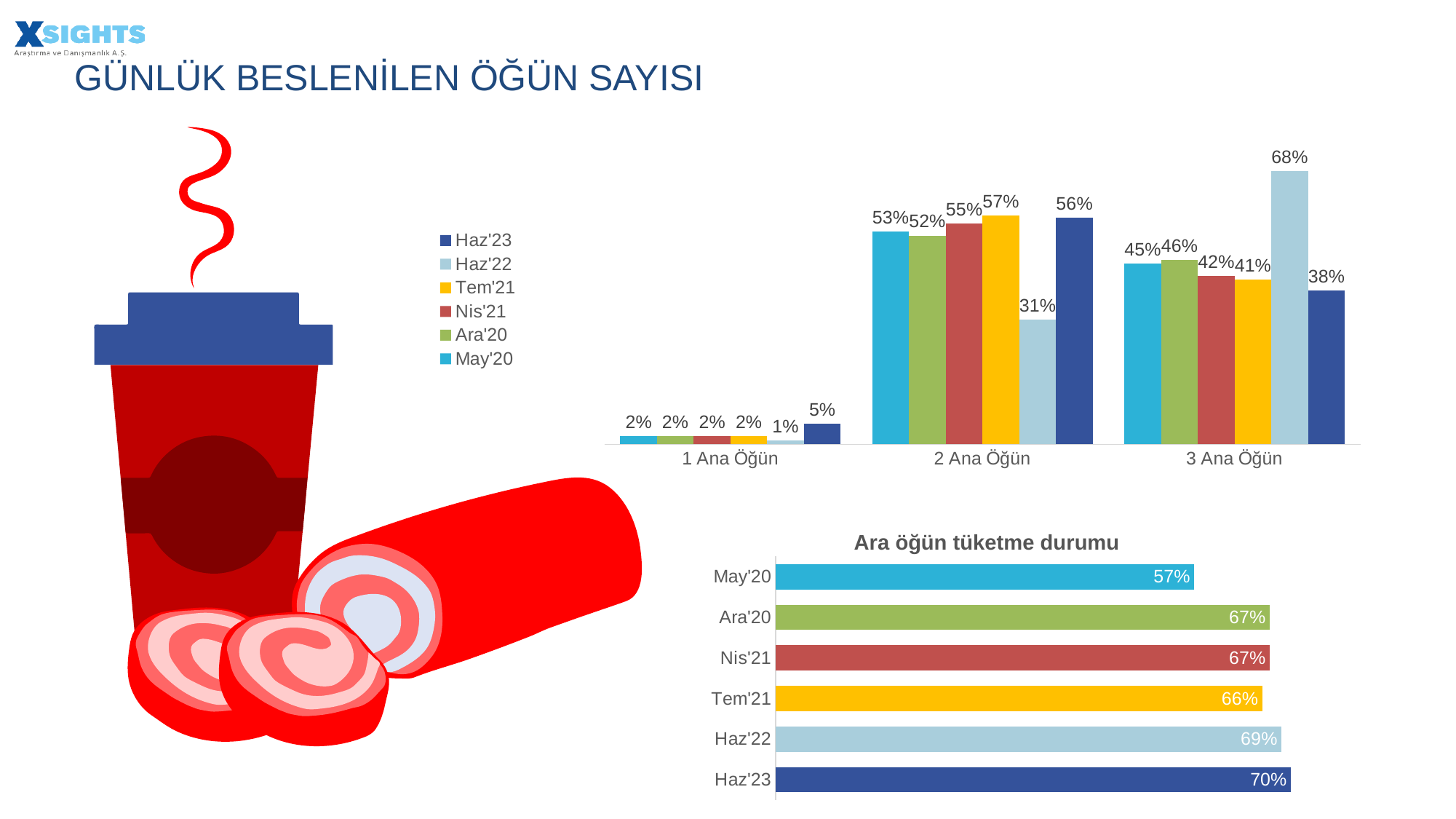
In the top grouped bar chart, which is larger for 2 Ana Öğün: Tem'21 or Nis'21? Tem'21 In the top grouped bar chart, what is the Haz'23 value for 2 Ana Öğün? 56% In the top grouped bar chart, what is the Haz'22 value for 3 Ana Öğün? 68% In the top grouped bar chart, what is the difference between the Haz'22 and Haz'23 values for 3 Ana Öğün? 30% In the 'Ara öğün tüketme durumu' chart, which period has the highest value? Haz'23 In the 'Ara öğün tüketme durumu' chart, what is the value for Tem'21? 66% How many categories are shown on the x axis of the top grouped bar chart? 3 In the top grouped bar chart, which series has the highest value for 1 Ana Öğün? Haz'23 What kind of chart is 'Ara öğün tüketme durumu'? Bar chart In the top grouped bar chart, which series has the lowest value for 2 Ana Öğün? Haz'22 How many series does the legend of the top grouped bar chart list? 6 In the top grouped bar chart, what is the Haz'22 value for 1 Ana Öğün? 1%